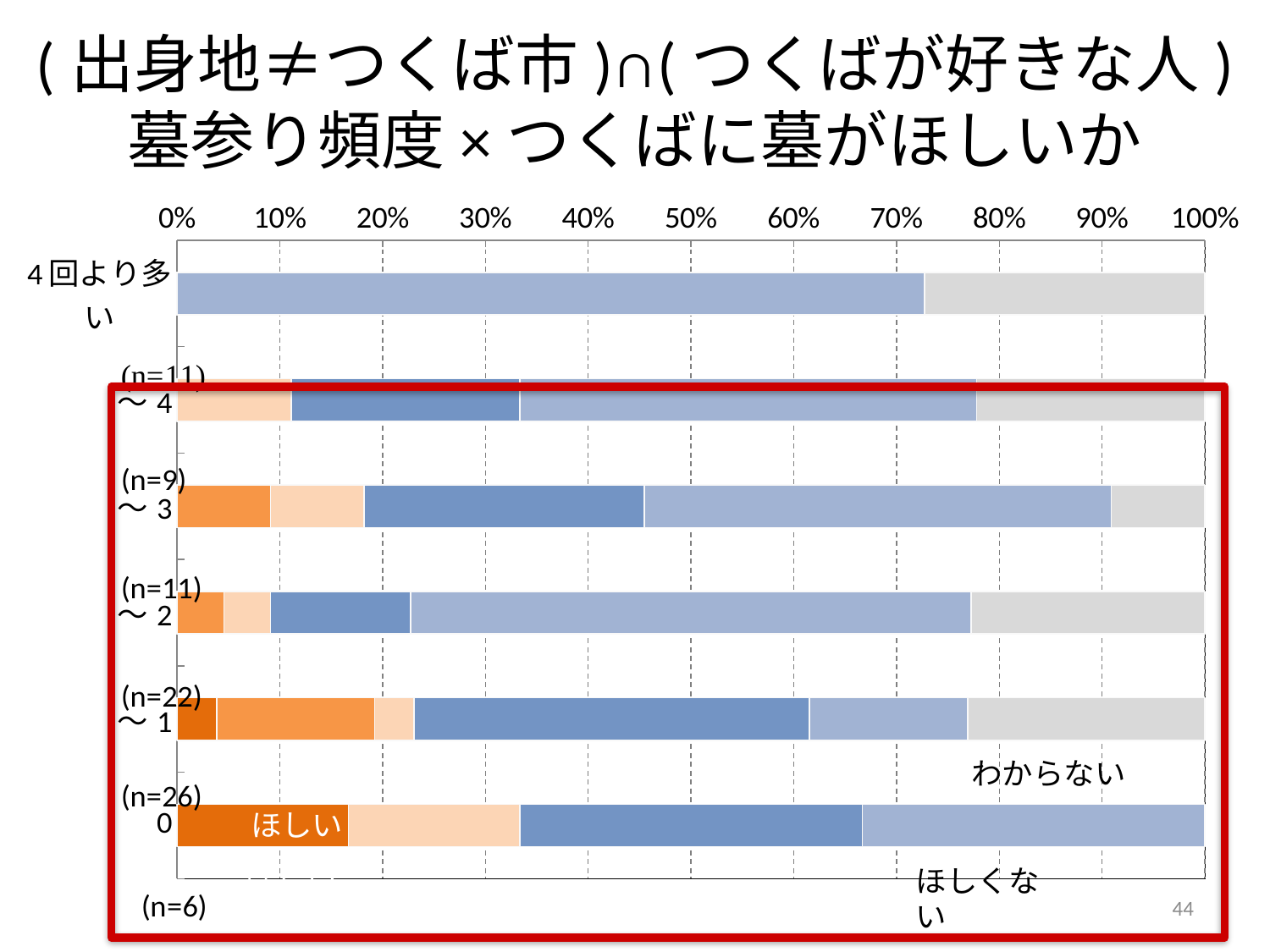
What is the maximum value shown on the horizontal axis? 100% In the 4回より多い row, does the light blue segment end at a point greater or less than 60%? greater How many categories (rows) are plotted on the chart? 6 In the 0 row, is the dark orange ほしい segment greater or less than 20%? less In the ～1 row, does the dark blue segment end at a point greater or less than 50%? greater What kind of chart is shown on the slide? Stacked bar chart Which row has the longest dark orange ほしい segment, 0 or ～1? 0 Which category's bar has no grey わからない segment? 0 What sample size (n) is shown for the 0 category? (n=6)